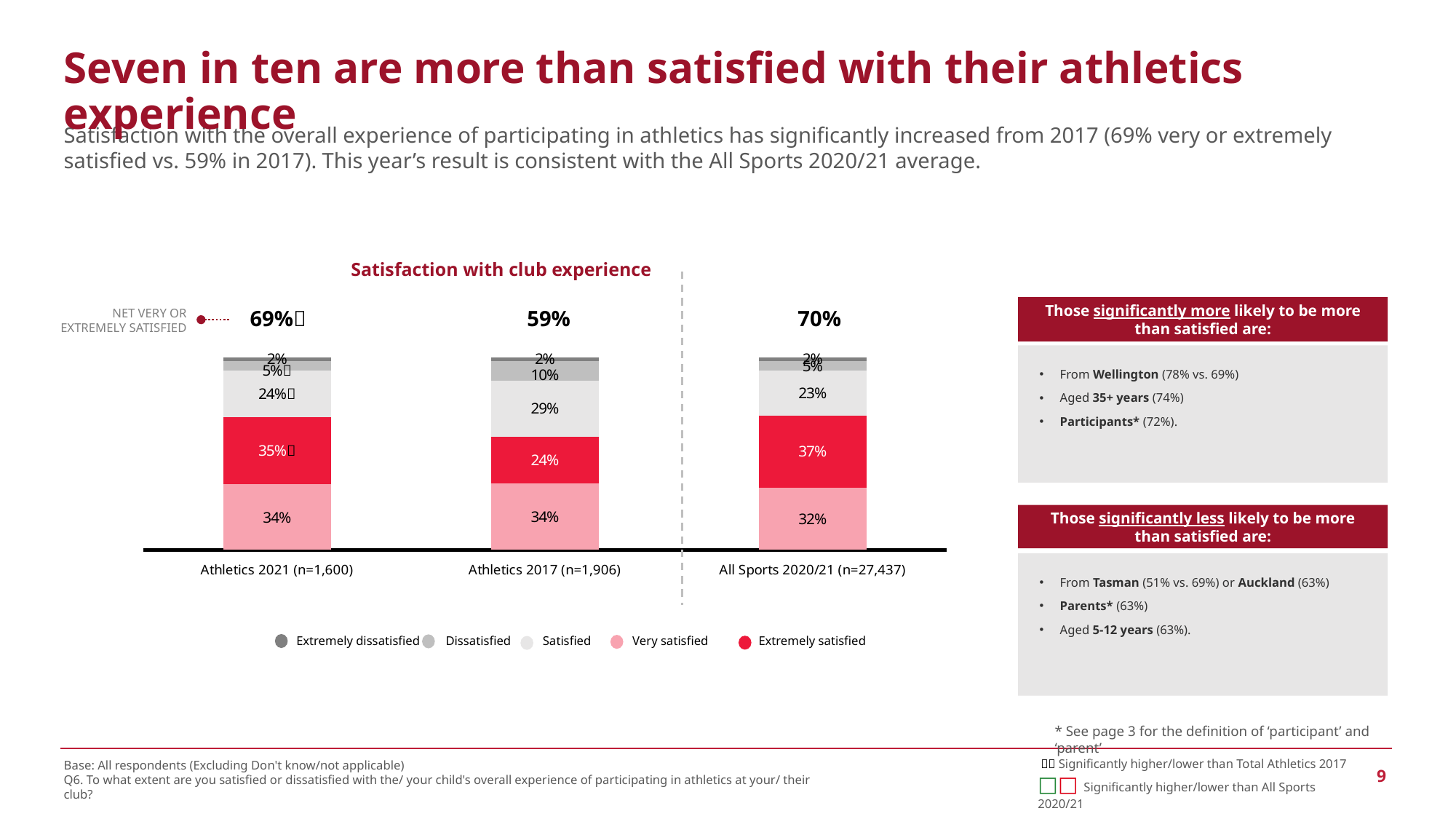
What is the 'Satisfied' value for Athletics 2017 (n=1,906)? 29% Which category has the lowest 'Extremely satisfied' value? Athletics 2017 (n=1,906) Which is larger: the 'Satisfied' value for Athletics 2021 (n=1,600) or for All Sports 2020/21 (n=27,437)? Athletics 2021 (n=1,600) What is the net very or extremely satisfied figure for Athletics 2017 (n=1,906)? 59% What is the 'Very satisfied' value for All Sports 2020/21 (n=27,437)? 32% What is the 'Extremely satisfied' value for Athletics 2021 (n=1,600)? 35% How many series does the legend of the 'Satisfaction with club experience' chart list? 5 How many categories (bars) are shown in the 'Satisfaction with club experience' chart? 3 What kind of chart is shown under the title 'Satisfaction with club experience'? Stacked bar chart Which category has the highest net very or extremely satisfied figure? All Sports 2020/21 (n=27,437) What is the difference between the 'Extremely satisfied' values for Athletics 2021 (n=1,600) and Athletics 2017 (n=1,906)? 11% What is the 'Dissatisfied' value for Athletics 2017 (n=1,906)? 10%